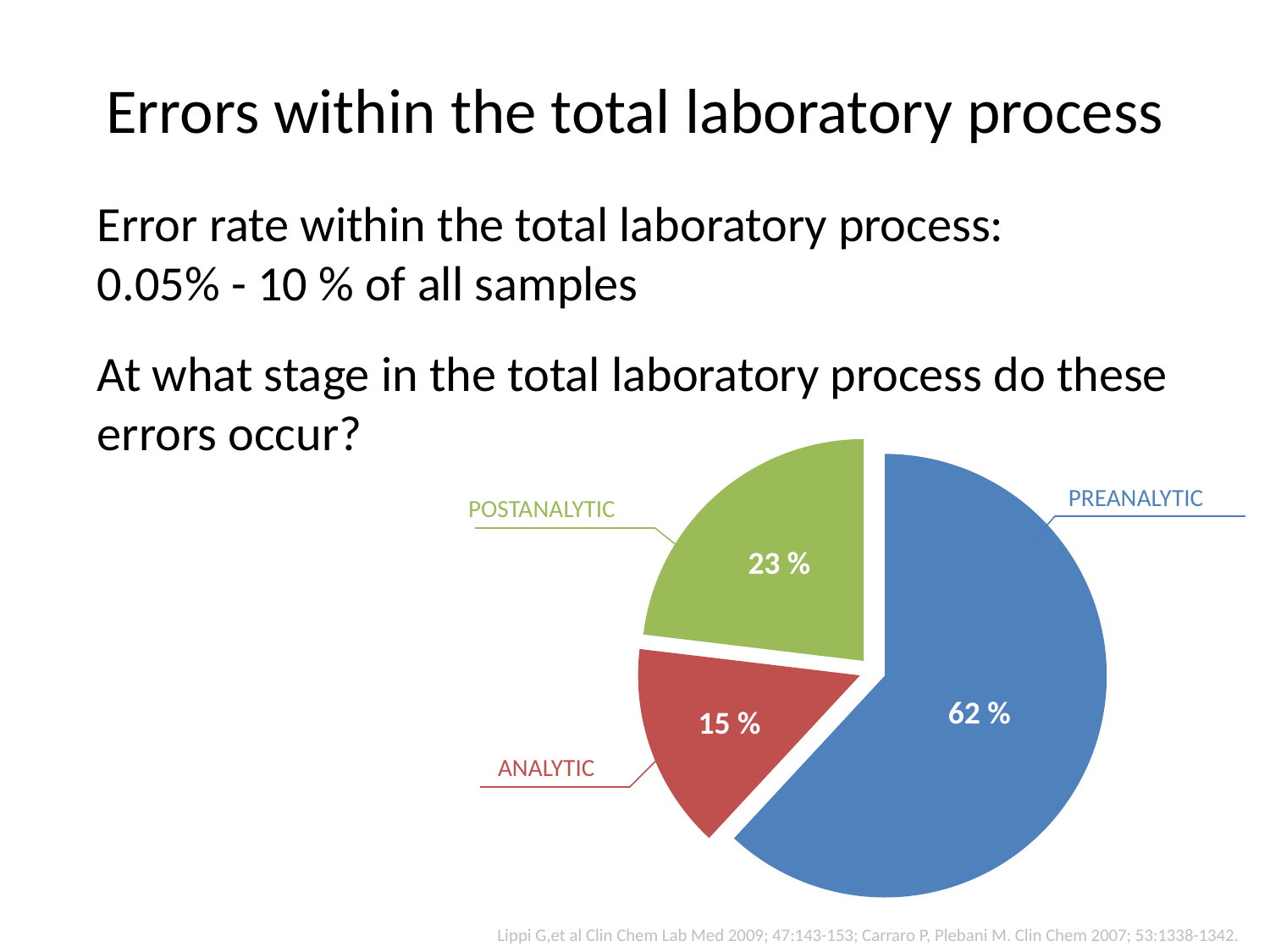
What colour is the PREANALYTIC slice? blue Which is larger, the POSTANALYTIC share or the ANALYTIC share? POSTANALYTIC What share of errors is attributed to the PREANALYTIC stage? 62 % Which stage accounts for the smallest share of errors? ANALYTIC What type of chart is shown on the slide? pie chart What share of errors is attributed to the ANALYTIC stage? 15 % What share of errors is attributed to the POSTANALYTIC stage? 23 % How many slices does the pie chart have? 3 What colour is the ANALYTIC slice? red What is the difference in percentage points between the POSTANALYTIC and ANALYTIC shares? 8 What is the difference in percentage points between the PREANALYTIC and POSTANALYTIC shares? 39 Which stage accounts for the largest share of errors? PREANALYTIC